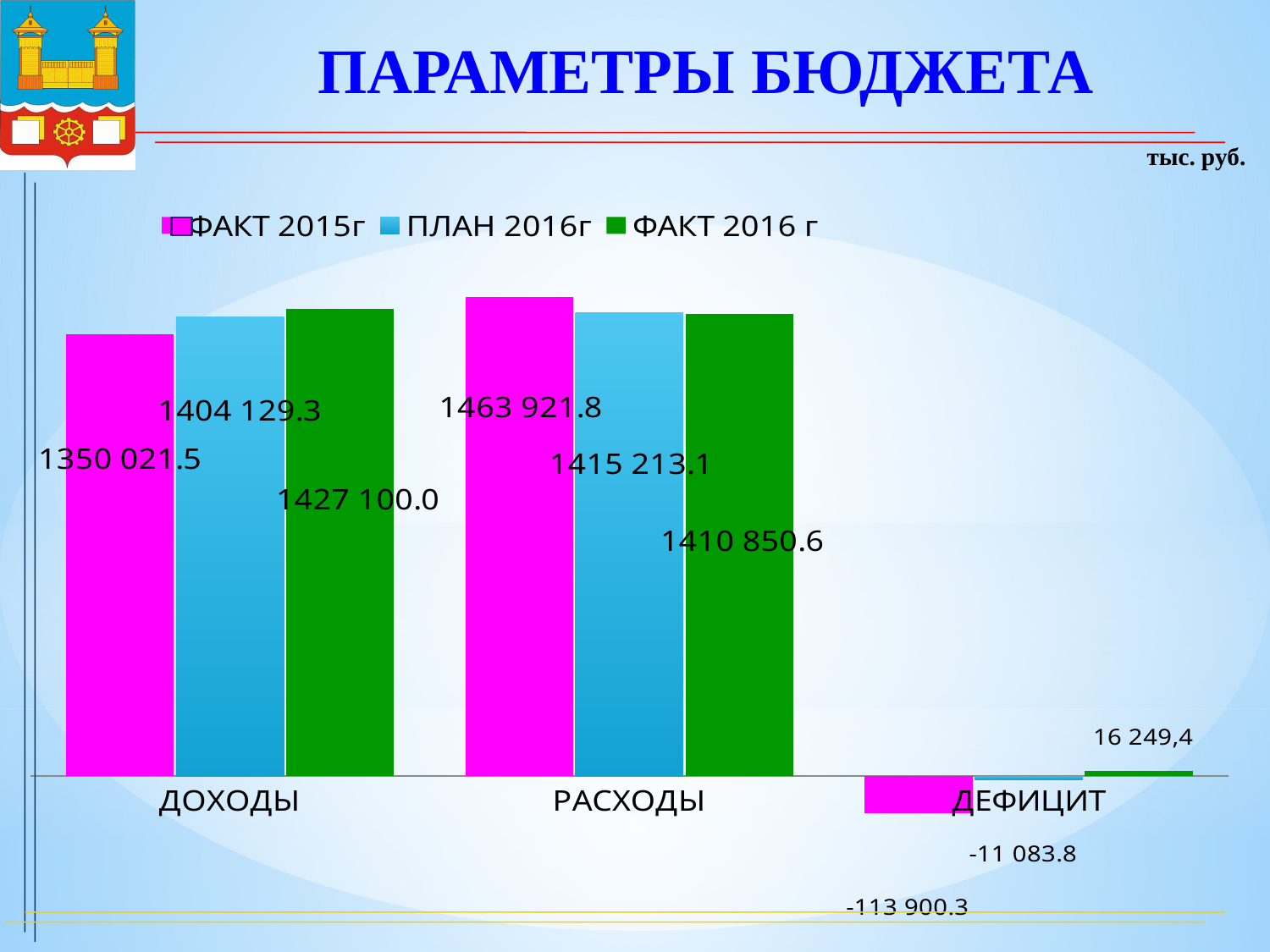
What type of chart is shown on the slide? bar chart What is the difference between ФАКТ 2016 г and ФАКТ 2015г for ДОХОДЫ? 77 078.5 What is the value of ФАКТ 2016 г for ДЕФИЦИТ? 16 249,4 How many series does the legend list? 3 What is the value of ПЛАН 2016г for ДОХОДЫ? 1404 129.3 What is the value of ФАКТ 2015г for ДЕФИЦИТ? -113 900.3 What is the value of ФАКТ 2016 г for РАСХОДЫ? 1410 850.6 Which series has the highest value for РАСХОДЫ? ФАКТ 2015г Which series has the lowest value for ДОХОДЫ? ФАКТ 2015г Which is larger for ПЛАН 2016г: ДОХОДЫ or РАСХОДЫ? РАСХОДЫ What is the value of ФАКТ 2015г for ДОХОДЫ? 1350 021.5 How many categories are shown on the x axis? 3